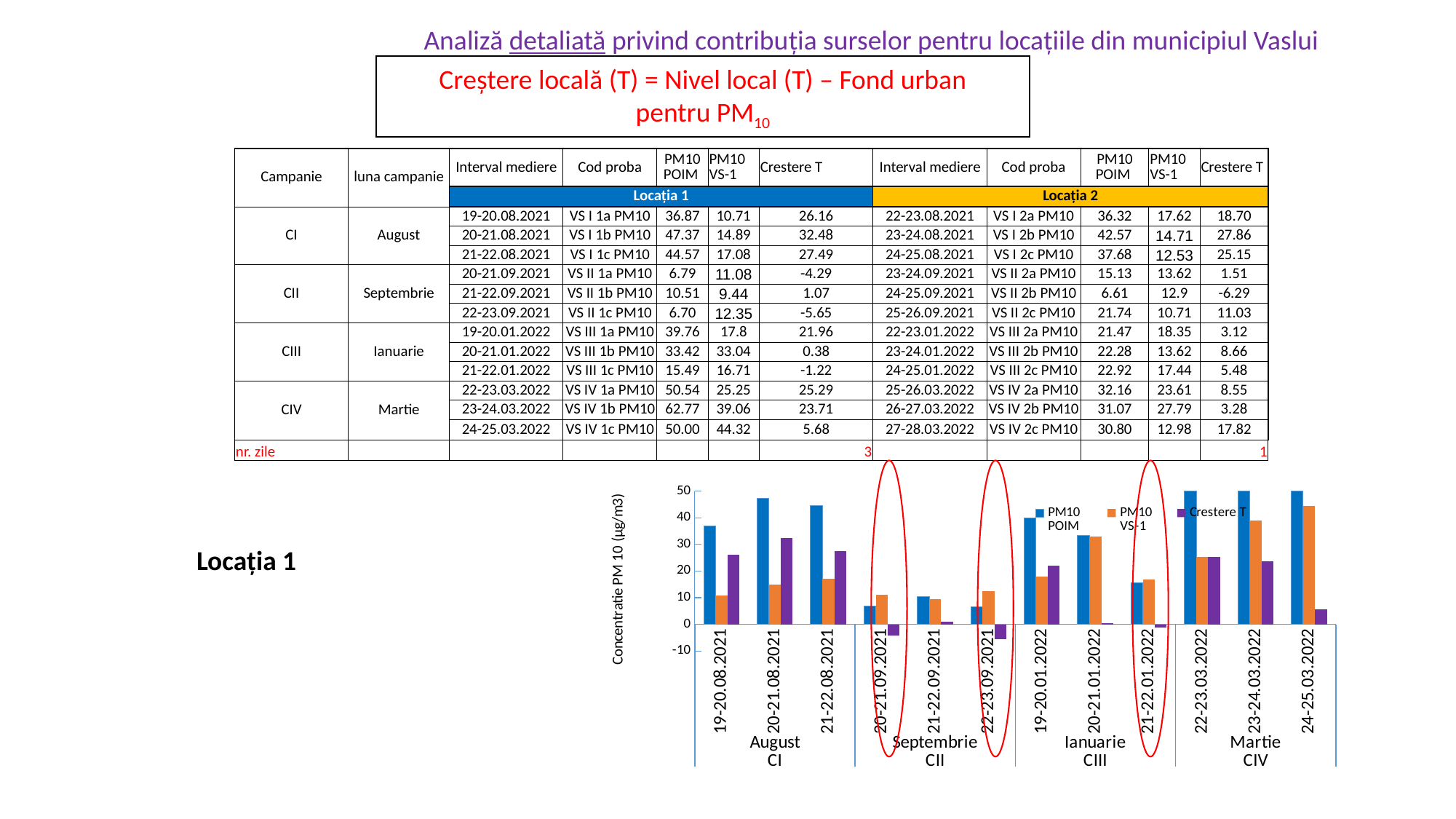
Is the PM10 POIM value for 19-20.08.2021 greater or less than 30? greater Is the PM10 VS-1 value for 20-21.09.2021 greater or less than 20? less What kind of chart is shown on the slide? bar chart For 19-20.01.2022, which is larger: PM10 POIM or PM10 VS-1? PM10 POIM How many series does the chart legend list? 3 How many sampling intervals (categories) are plotted along the x axis of the chart? 12 What is the label of the chart's vertical axis? Concentratie PM 10 (µg/m3) For which sampling interval is the Crestere T bar highest in the chart? 20-21.08.2021 What is the Crestere T value for 19-20.08.2021 at Locația 1? 26.16 What is the PM10 VS-1 value for 24-25.03.2022 at Locația 1? 44.32 By how much does the Crestere T value for 20-21.08.2021 exceed that for 19-20.08.2021 at Locația 1? 6.32 Which location does the bar chart show? Locația 1